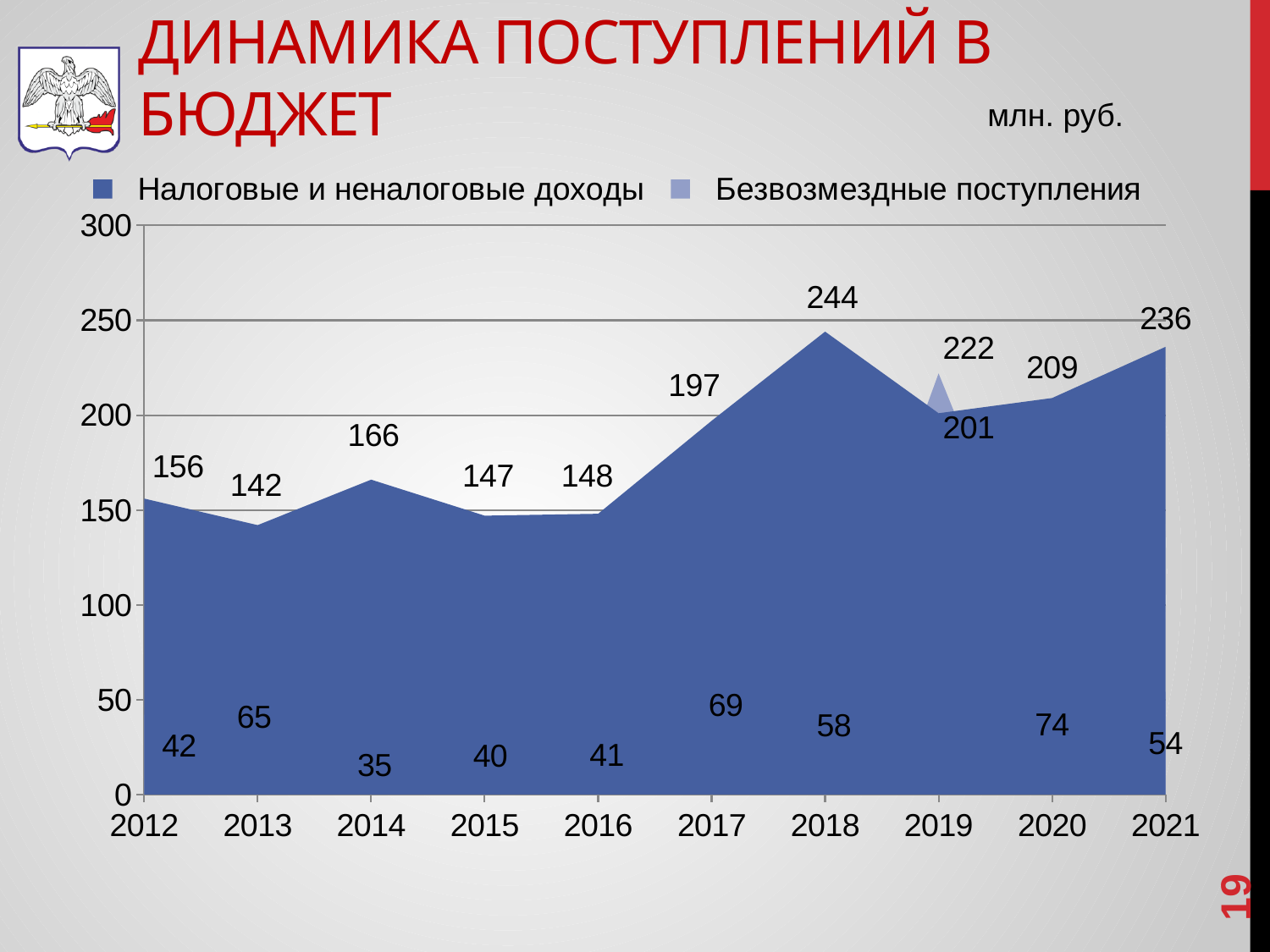
In which year is Безвозмездные поступления lowest? 2014 What is the difference between Налоговые и неналоговые доходы in 2021 and in 2020? 27 How many years are shown on the x axis? 10 Did Налоговые и неналоговые доходы rise or fall from 2016 to 2018? Rise How many series does the legend list? 2 What type of chart is shown on the slide? Area chart What is the value of Налоговые и неналоговые доходы in 2018? 244 What is the value of Налоговые и неналоговые доходы in 2013? 142 Which is larger in 2019: Налоговые и неналоговые доходы or Безвозмездные поступления? Безвозмездные поступления In which year is Налоговые и неналоговые доходы highest? 2018 What unit of measurement is indicated on the slide? млн. руб. What is the value of Безвозмездные поступления in 2020? 74